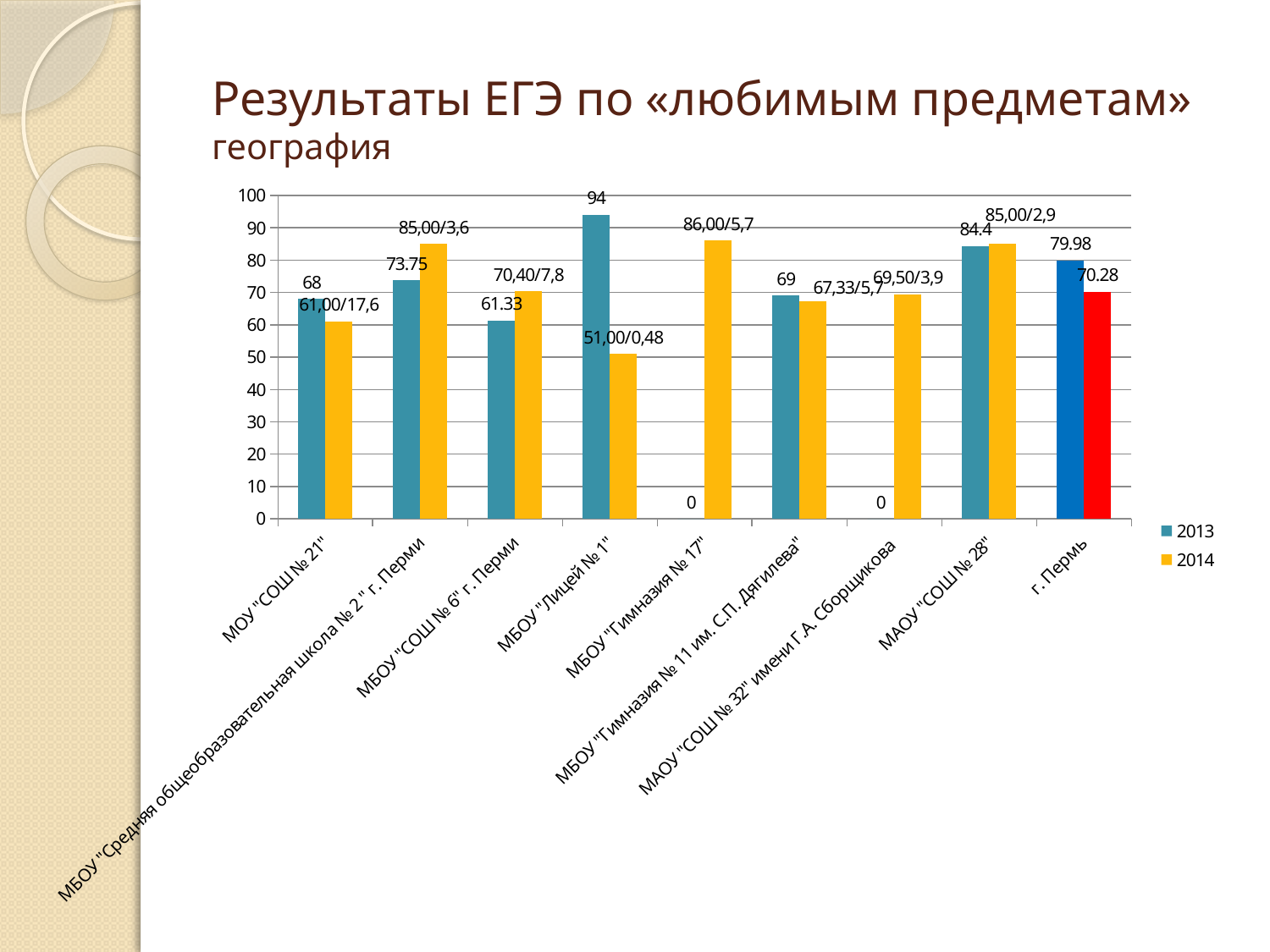
How many series does the legend list? 2 Which category has the lowest 2014 value? МБОУ "Лицей № 1" What kind of chart is shown on the slide? Bar chart Which category has the highest 2013 value? МБОУ "Лицей № 1" Which subject is named in the subtitle under the chart title? география What is the 2013 value for МАОУ "СОШ № 28"? 84.4 For МБОУ "СОШ № 6" г. Перми, which is larger: the 2013 value or the 2014 value? 2014 What is the difference between the 2013 and 2014 values for г. Пермь? 9.7 What is the 2014 value for г. Пермь? 70.28 What is the 2014 data label for МБОУ "Гимназия № 17"? 86,00/5,7 What is the 2013 value for МБОУ "Лицей № 1"? 94 How many categories are shown on the x axis? 9